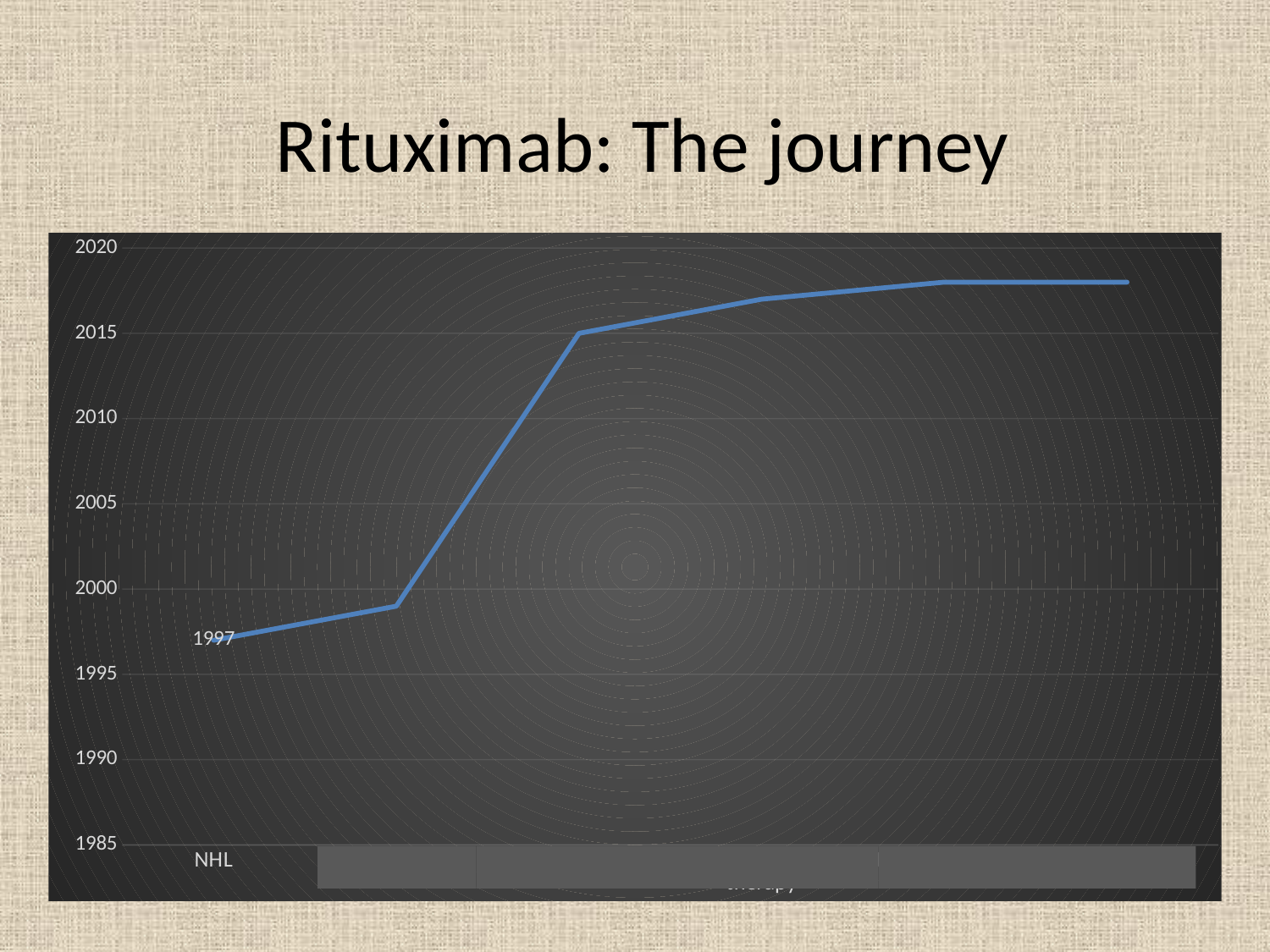
What kind of chart is shown on the slide? line chart What value is labelled on the line for the NHL category? 1997 Is the value for NHL greater or less than 2000? less What is the title of the slide containing the chart? Rituximab: The journey Is the value of the third point on the line greater or less than 2010? greater Do the values on the line rise or fall from left to right along the x axis? rise How many data points are plotted on the line? 6 What is the highest value shown on the vertical axis? 2020 Is the value of the last point on the line greater or less than 2015? greater Which category has the lowest value on the line? NHL